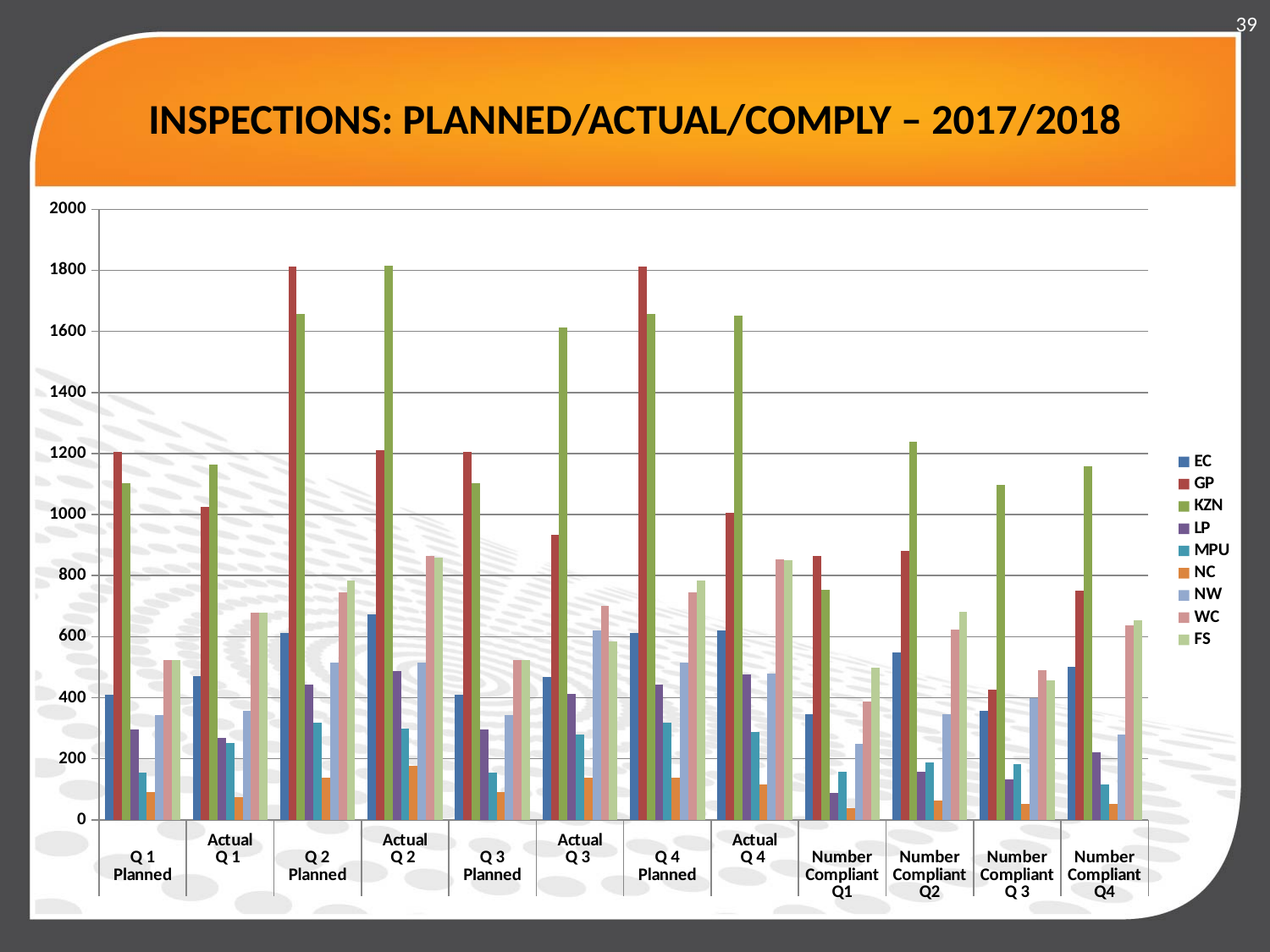
What is the title of the chart? INSPECTIONS: PLANNED/ACTUAL/COMPLY – 2017/2018 What kind of chart is shown on the slide? bar chart In the Q 2 Planned category, which is larger, GP or KZN? GP Which series has the lowest value in the Q 1 Planned category? NC How many categories are shown along the x axis? 12 How many series does the legend list? 9 Is the value for NC in Number Compliant Q1 greater or less than 200? less Is the value for GP in Q 2 Planned greater or less than 1600? greater Which series has the highest value in the Q 1 Planned category? GP In the Actual Q 2 category, which is larger, GP or KZN? KZN Which series has the highest value in the Actual Q 4 category? KZN Which series has the lowest value in the Number Compliant Q1 category? NC